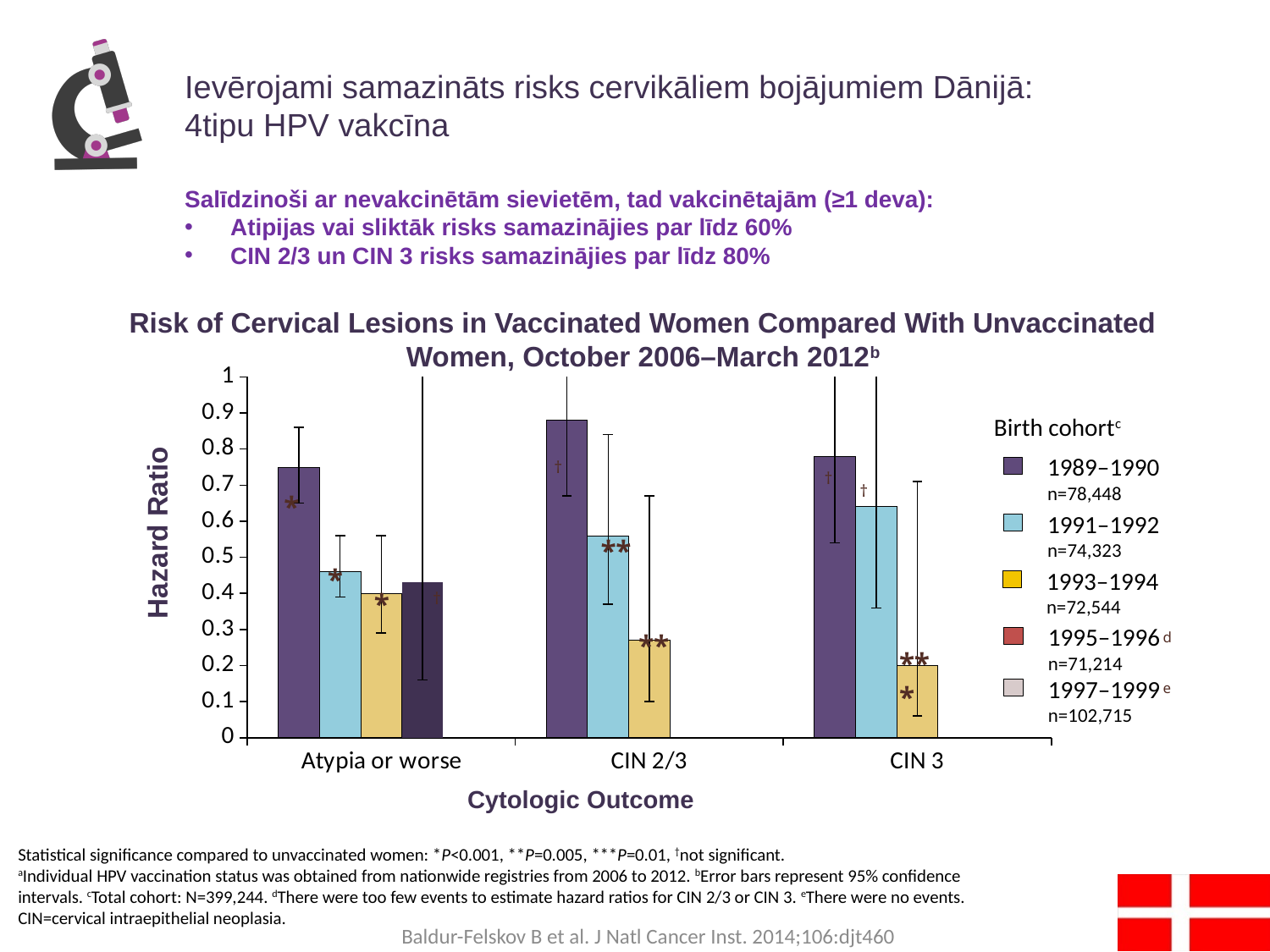
Is the hazard ratio for the 1989–1990 cohort for CIN 2/3 greater or less than 0.8? greater Which is larger: the hazard ratio for the 1989–1990 cohort for CIN 2/3 or for CIN 3? CIN 2/3 How many cytologic outcome categories are shown on the x axis? 3 What kind of chart is shown on the slide? bar chart Is the hazard ratio for the 1993–1994 cohort for CIN 2/3 greater or less than 0.4? less Which birth cohort has the lowest hazard ratio for CIN 3? 1993–1994 According to the legend, what is the n for the 1989–1990 birth cohort? n=78,448 Which birth cohort has the highest hazard ratio for Atypia or worse? 1989–1990 How many birth cohorts does the legend list? 5 What is the label of the y axis? Hazard Ratio Is the hazard ratio for the 1993–1994 cohort for CIN 3 greater or less than 0.3? less